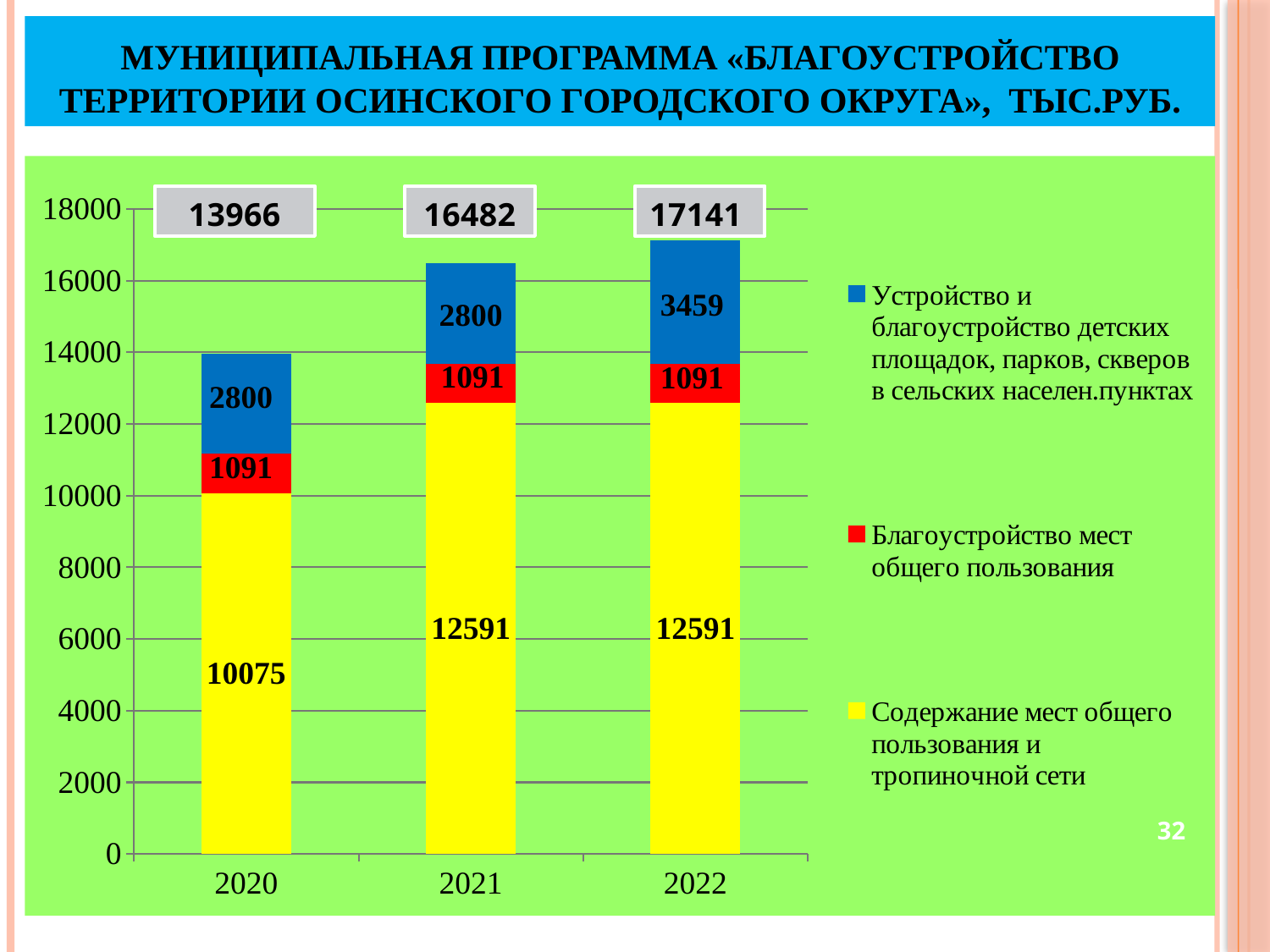
What is the total of the stacked bar for 2022? 17141 What is the difference between the totals for 2021 and 2020? 2516 Do the total values rise or fall from 2020 to 2022? rise How many years (categories) are shown on the x axis? 3 What kind of chart is shown on the slide? stacked bar chart Which year has the lowest total? 2020 How many series does the legend list? 3 Which is larger: the value for «Устройство и благоустройство детских площадок, парков, скверов в сельских населен.пунктах» in 2022 or in 2021? 2022 What is the value for «Благоустройство мест общего пользования» in 2021? 1091 What is the value for «Содержание мест общего пользования и тропиночной сети» in 2020? 10075 Which year has the highest total? 2022 What is the value for «Устройство и благоустройство детских площадок, парков, скверов в сельских населен.пунктах» in 2022? 3459